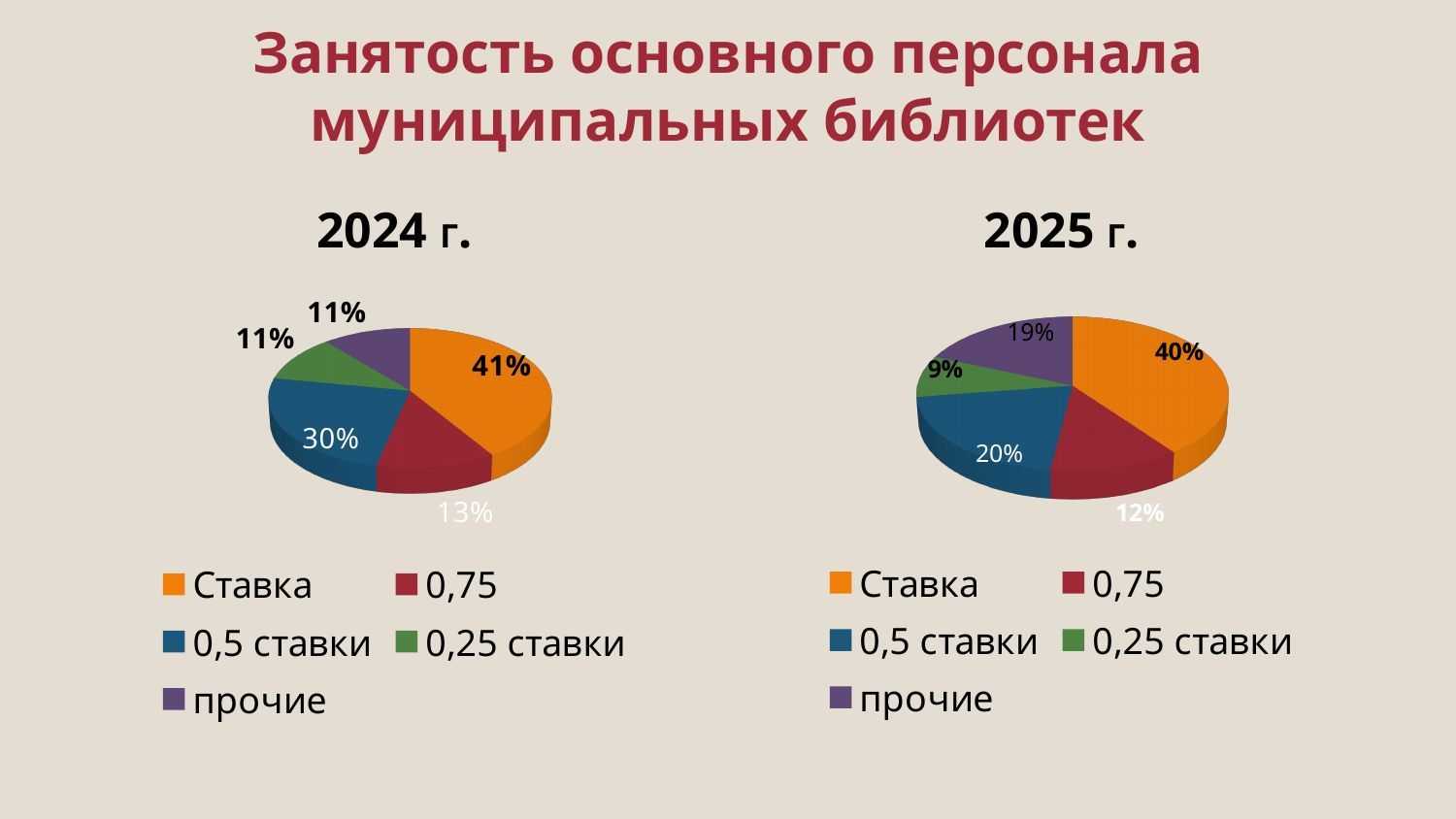
In the 2025 г. chart, what share does 0,25 ставки have? 9% In the 2025 г. chart, what share does прочие have? 19% In the 2024 г. chart, what share does Ставка have? 41% In the 2025 г. chart, which category has the largest share? Ставка In the 2024 г. chart, which category has the largest share? Ставка In the 2024 г. chart, which is larger: the share of 0,5 ставки or the share of 0,75? 0,5 ставки In the 2024 г. chart, what share does 0,5 ставки have? 30% In the 2024 г. chart, what share does 0,75 have? 13% In the 2025 г. chart, which category has the smallest share? 0,25 ставки What type of chart is the 2024 г. chart? Pie chart How many categories does the 2025 г. chart show? 5 In the 2025 г. chart, what is the difference between the shares of Ставка and 0,5 ставки? 20%